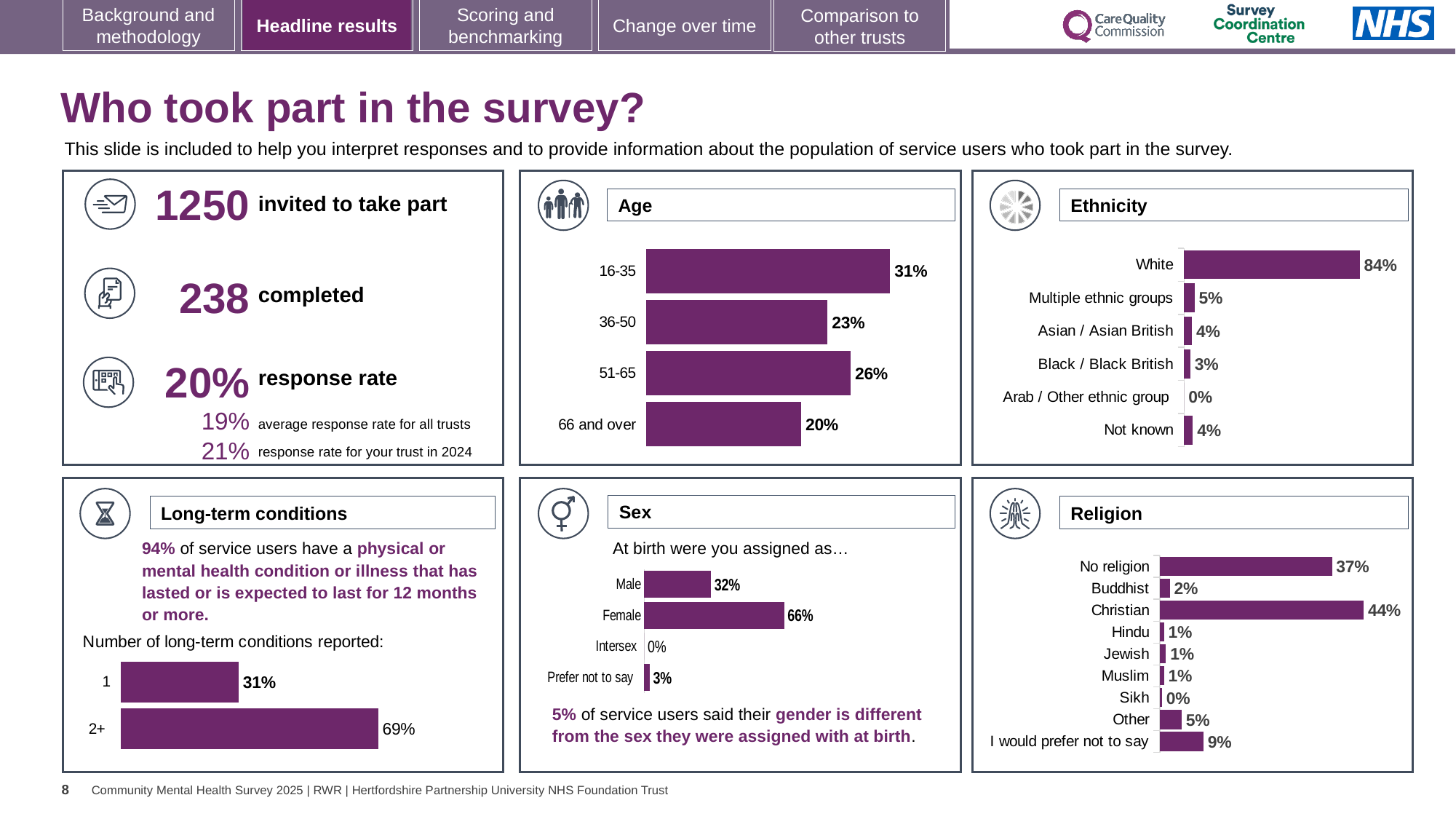
In the Sex chart, which is larger, Male or Female? Female In the Long-term conditions chart, what percentage of service users reported 2+ long-term conditions? 69% What kind of chart is the Age chart? Bar chart In the Ethnicity chart, what is the difference between White and Multiple ethnic groups? 79% In the Ethnicity chart, what is the value for White? 84% In the Age chart, which age group has the lowest percentage? 66 and over In the Ethnicity chart, how many ethnicity categories are shown? 6 In the Age chart, what percentage of respondents were aged 16-35? 31% In the Religion chart, which category has the highest percentage? Christian In the Religion chart, what is the value for I would prefer not to say? 9% In the Sex chart, what percentage of respondents answered Prefer not to say? 3% In the Religion chart, what is the difference between Christian and No religion? 7%